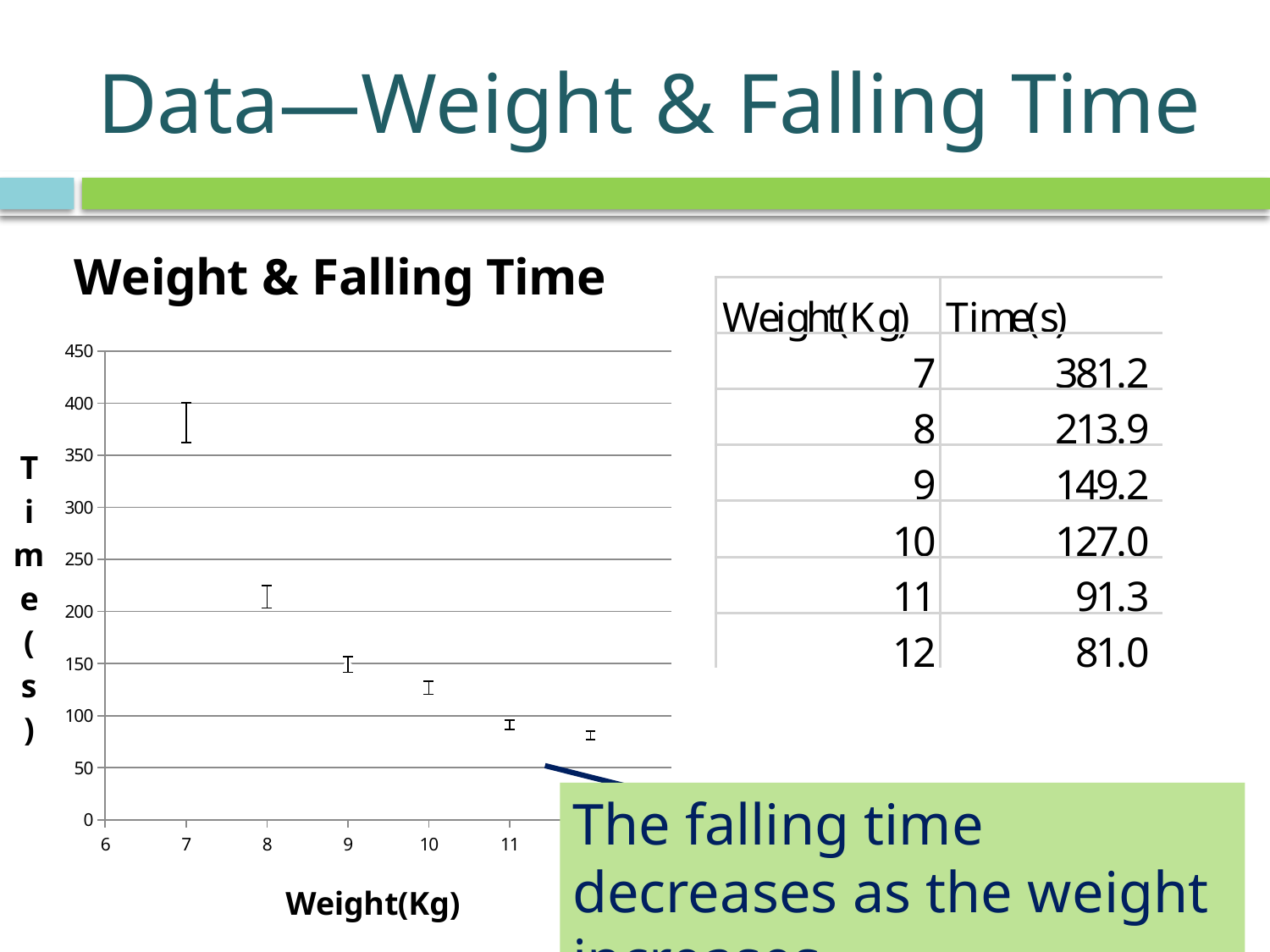
According to the table, what is the falling time for a weight of 10 Kg? 127.0 How many data points are plotted in the chart? 6 Which weight has the highest falling time? 7 What is the difference in falling time between a weight of 8 Kg and a weight of 9 Kg, using the table values? 64.7 What kind of chart is shown on the slide? scatter chart Which has a larger falling time, a weight of 9 Kg or a weight of 11 Kg? 9 Kg Does the falling time rise or fall as the weight increases along the x axis? fall Is the plotted falling time for a weight of 7 Kg greater or less than 350? greater What is the title of the chart? Weight & Falling Time Which weight has the lowest falling time? 12 According to the table, what is the falling time for a weight of 7 Kg? 381.2 According to the table, what is the falling time for a weight of 12 Kg? 81.0